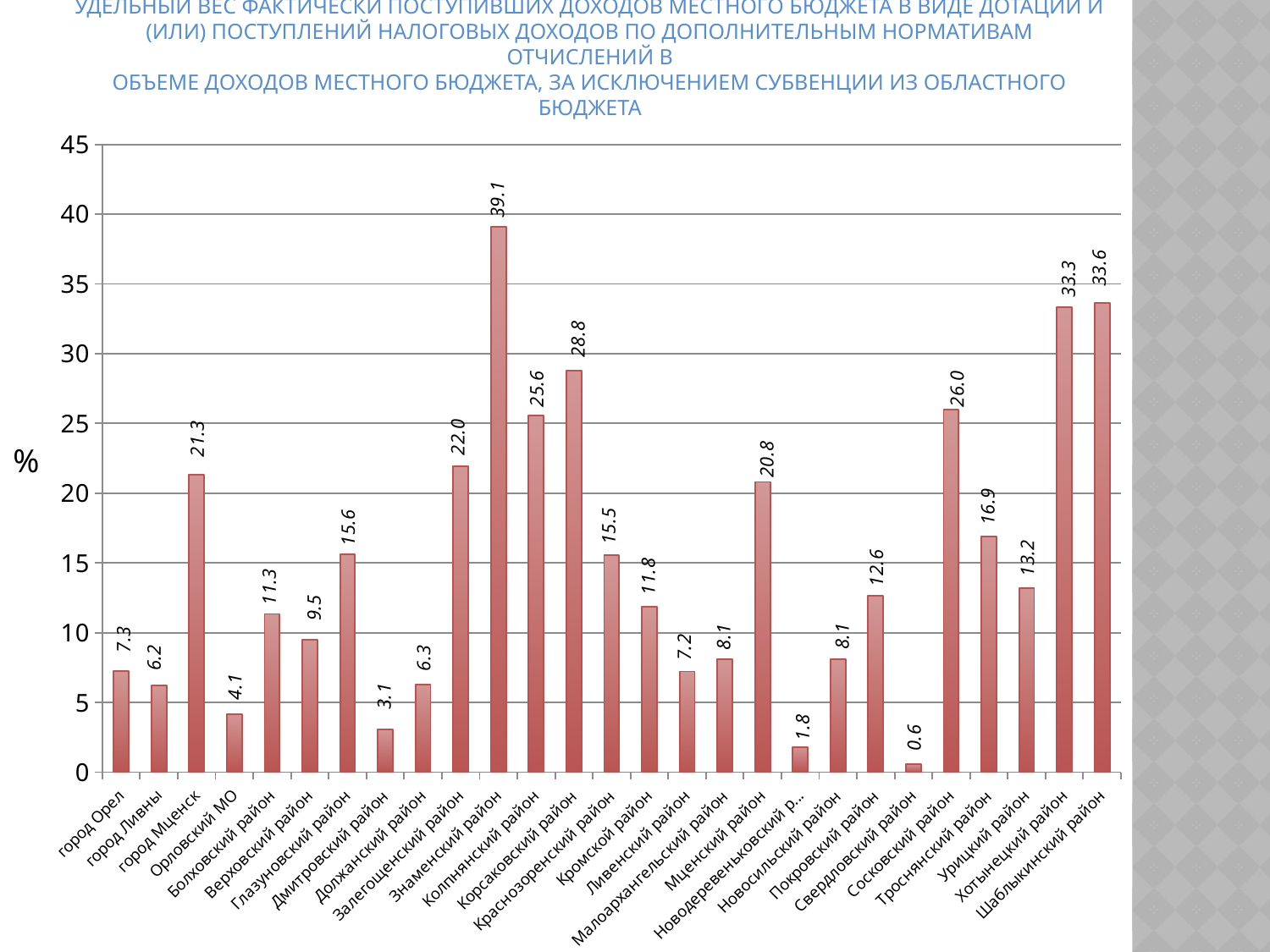
Which category has the highest value? Знаменский район What label is shown on the vertical axis? % What is the value for Знаменский район? 39.1 Which category has the lowest value? Свердловский район What is the difference between the values for Знаменский район and Корсаковский район? 10.3 Which is larger, the value for Колпнянский район or the value for Мценский район? Колпнянский район What is the value for Свердловский район? 0.6 What is the value for город Мценск? 21.3 How many categories are shown on the x axis? 27 What is the difference between the values for Шаблыкинский район and Хотынецкий район? 0.3 What is the value for Сосковский район? 26.0 What kind of chart is shown on the slide? Bar chart